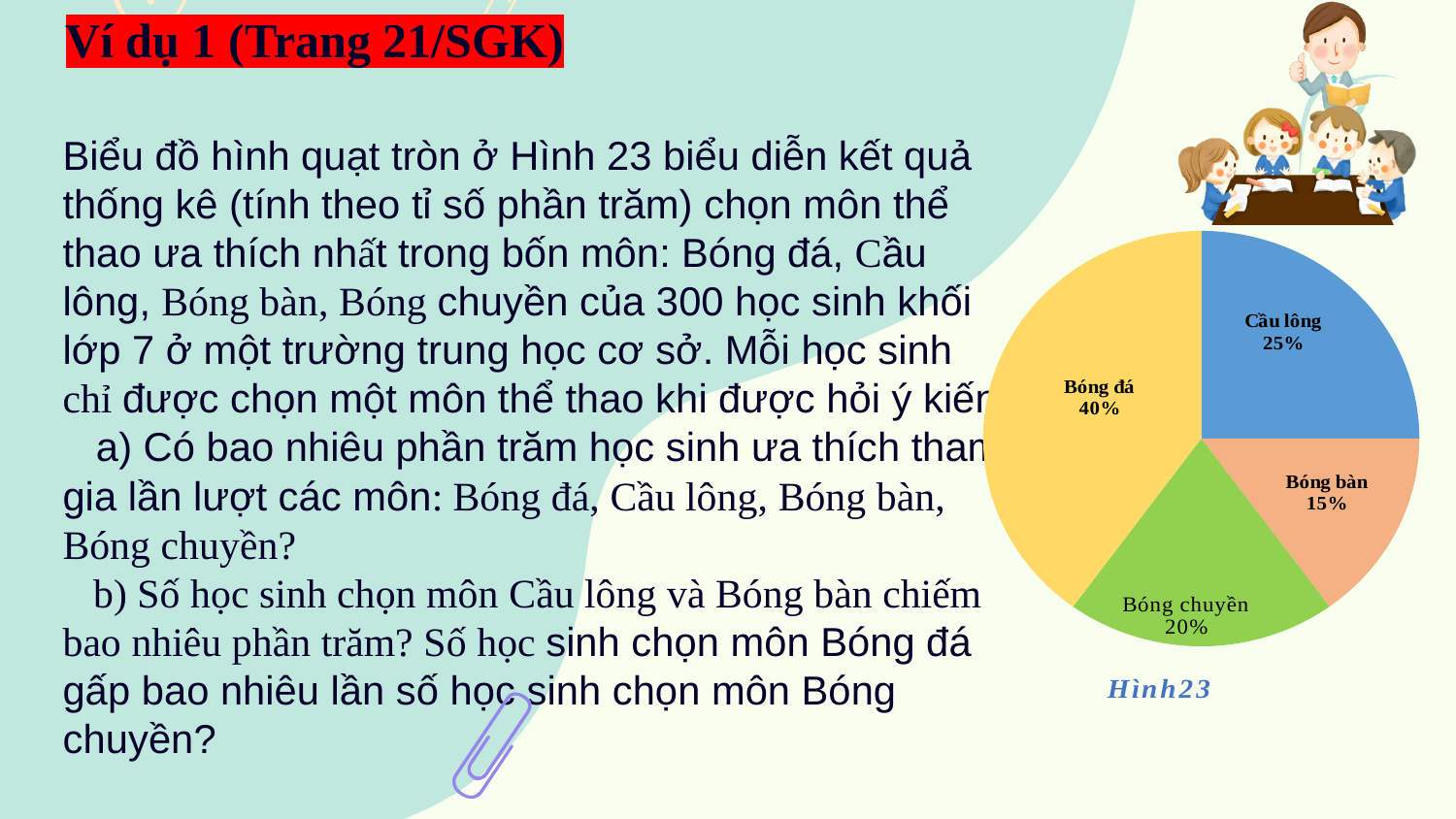
Which sport has the largest slice in the pie chart? Bóng đá What kind of chart is shown on the slide? pie chart What percentage of the pie chart is Bóng đá? 40% Which sport has the smallest slice in the pie chart? Bóng bàn What percentage of the pie chart is Cầu lông? 25% What is the caption printed below the pie chart? Hình23 How many slices does the pie chart have? 4 What is the combined percentage of Cầu lông and Bóng bàn? 40% What is the difference in percentage points between Bóng đá and Bóng chuyền? 20 What percentage of the pie chart is Bóng chuyền? 20% What percentage of the pie chart is Bóng bàn? 15% Which slice is larger, Cầu lông or Bóng chuyền? Cầu lông